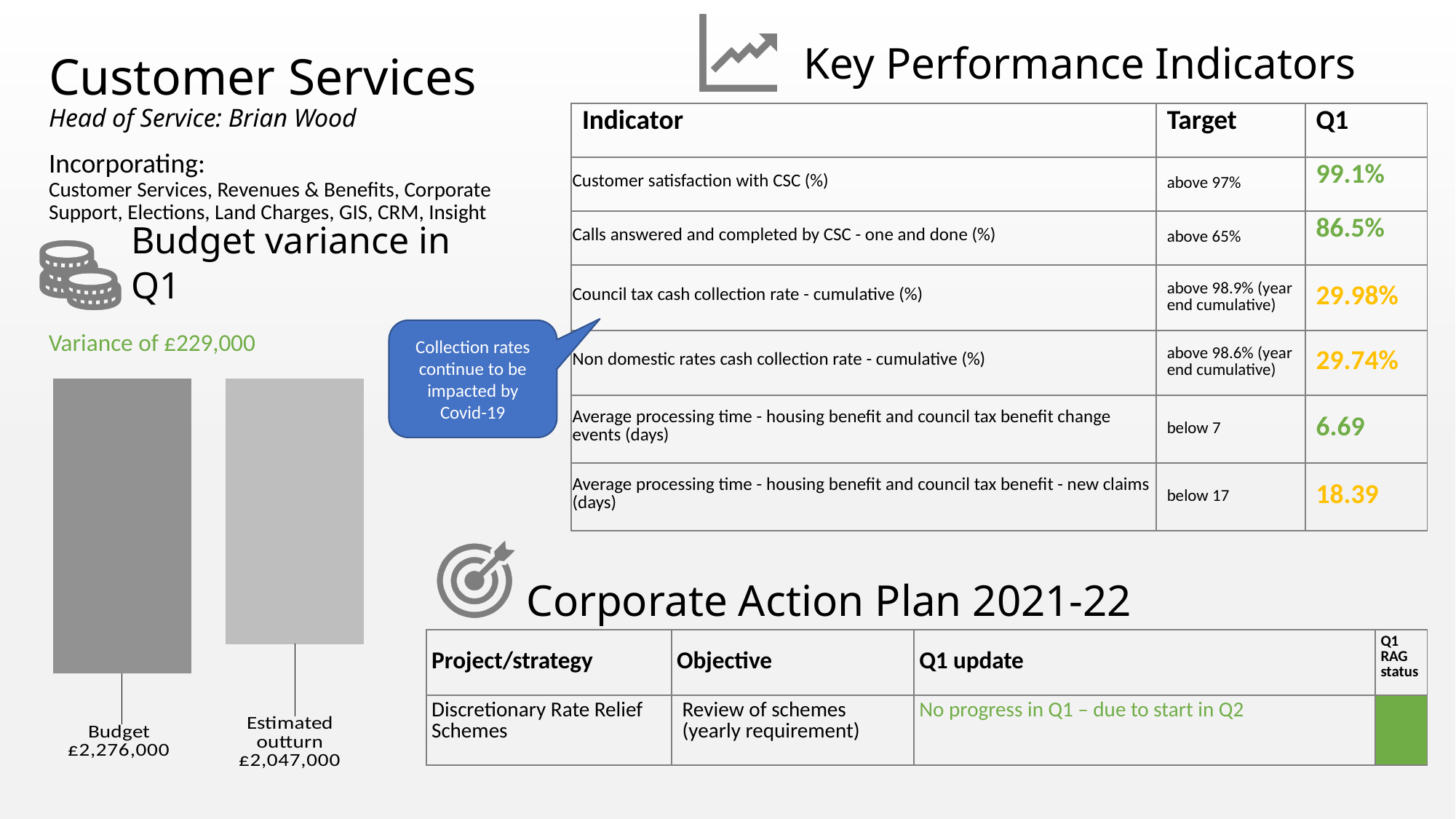
What kind of chart is shown under the 'Budget variance in Q1' heading? bar chart Do the values fall or rise from the Budget bar to the Estimated outturn bar in the 'Budget variance in Q1' chart? fall Which category has the highest value in the 'Budget variance in Q1' chart? Budget What is the value of the Estimated outturn bar in the 'Budget variance in Q1' chart? £2,047,000 What is the difference between the Budget and Estimated outturn values in the 'Budget variance in Q1' chart? £229,000 Which bar is taller in the 'Budget variance in Q1' chart, Budget or Estimated outturn? Budget What variance is stated above the 'Budget variance in Q1' chart? Variance of £229,000 What is the title of the chart on the left of the slide? Budget variance in Q1 Which category has the lowest value in the 'Budget variance in Q1' chart? Estimated outturn How many bars does the 'Budget variance in Q1' chart have? 2 What is the value of the Budget bar in the 'Budget variance in Q1' chart? £2,276,000